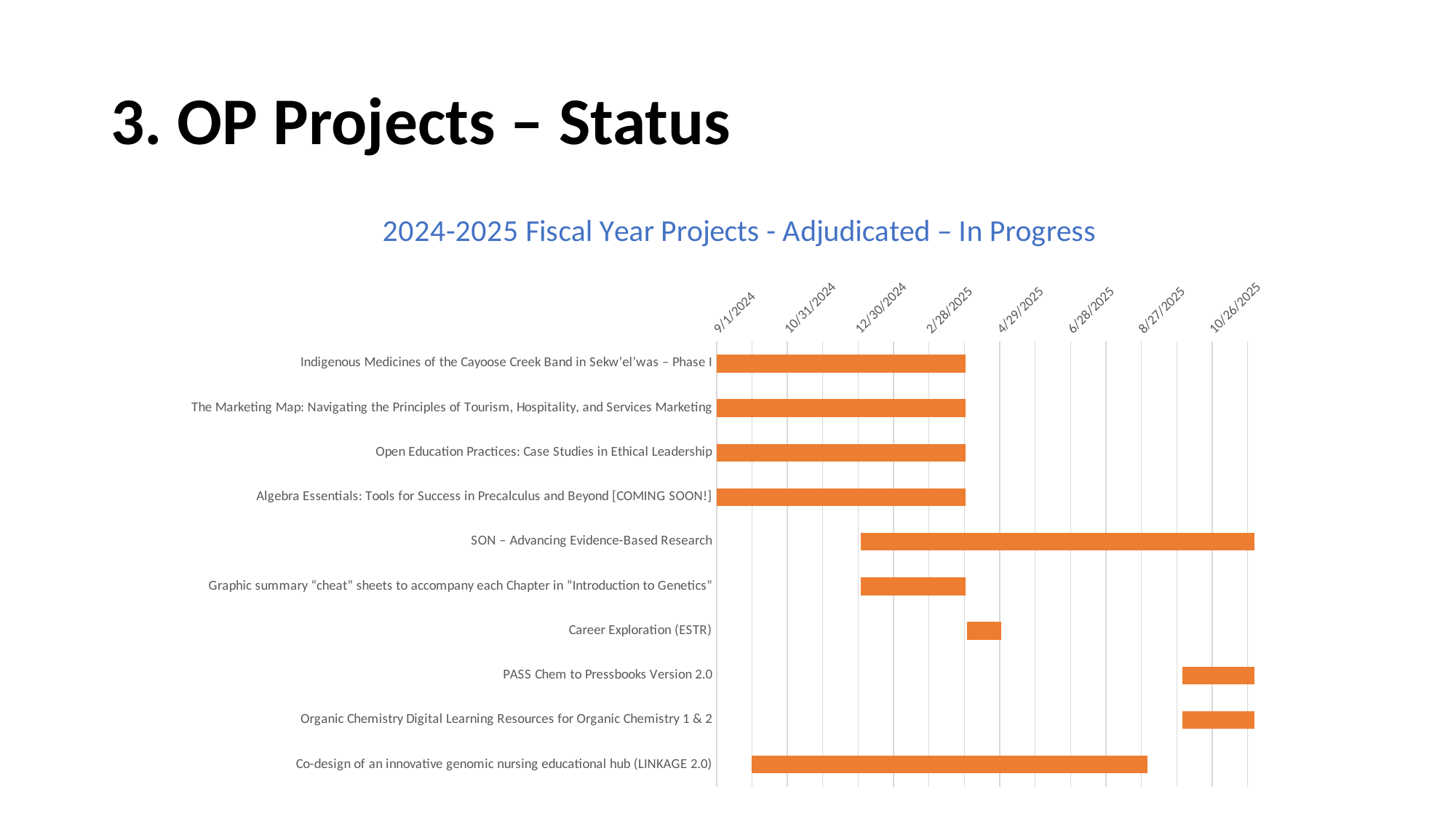
Which project has the shortest bar on the chart? Career Exploration (ESTR) How many projects are listed on the chart? 10 What is the title of the chart? 2024-2025 Fiscal Year Projects - Adjudicated – In Progress Which bar is longer: Career Exploration (ESTR) or Graphic summary “cheat” sheets to accompany each Chapter in “Introduction to Genetics”? Graphic summary “cheat” sheets to accompany each Chapter in “Introduction to Genetics” What is the earliest date shown on the chart's date axis? 9/1/2024 What kind of chart is shown on the slide? Bar chart